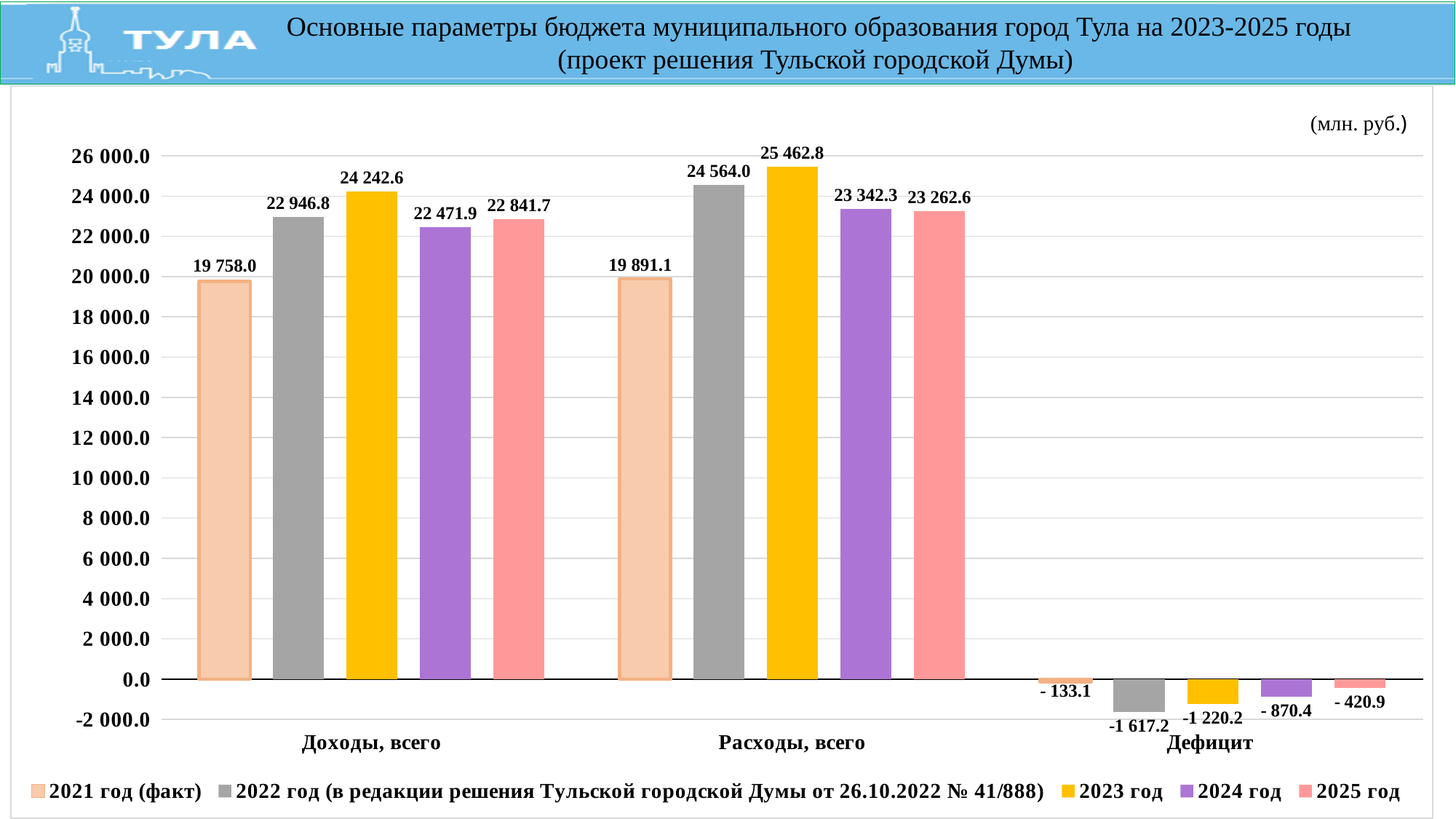
What is the difference between Расходы, всего and Доходы, всего for 2023 год? 1 220.2 Which series has the highest value in the Расходы, всего category? 2023 год What is the value for 2023 год in the Доходы, всего category? 24 242.6 What is the value for 2022 год in the Дефицит category? -1 617.2 What kind of chart is shown on the slide? bar chart How many categories are shown on the x axis? 3 What unit of measurement is indicated above the chart? млн. руб. Is the value for 2022 год in the Расходы, всего category greater or less than 24 000.0? greater In the Доходы, всего category, which is larger: the value for 2024 год or for 2025 год? 2025 год How many series does the legend list? 5 What is the value for 2025 год in the Расходы, всего category? 23 262.6 Which series has the lowest value in the Доходы, всего category? 2021 год (факт)